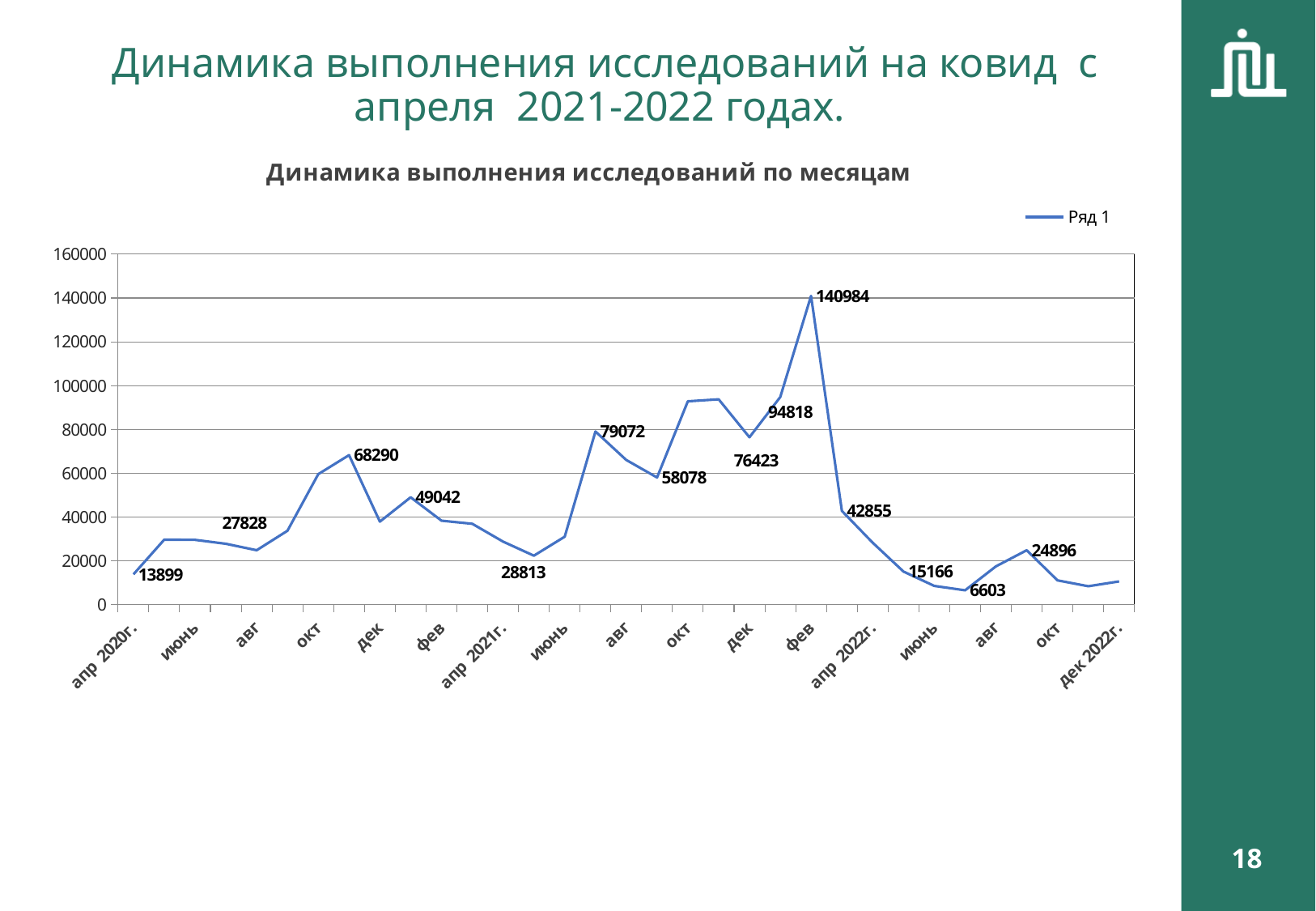
Is the value for дек 2022г. greater or less than 20000? less What is the title of the chart? Динамика выполнения исследований по месяцам What is the highest value labelled on the line? 140984 What is the difference between the highest labelled value (140984) and the value for апр 2020г. (13899)? 127085 Is the value for окт 2021 greater or less than 80000? greater What is the name of the series in the legend? Ряд 1 What is the lowest value labelled on the line? 6603 How many series does the legend list? 1 Which is larger, the labelled value 140984 or the labelled value 68290? 140984 What is the value for апр 2020г.? 13899 Does the line rise or fall from апр 2022г. to авг 2022? fall What kind of chart is shown on the slide? line chart